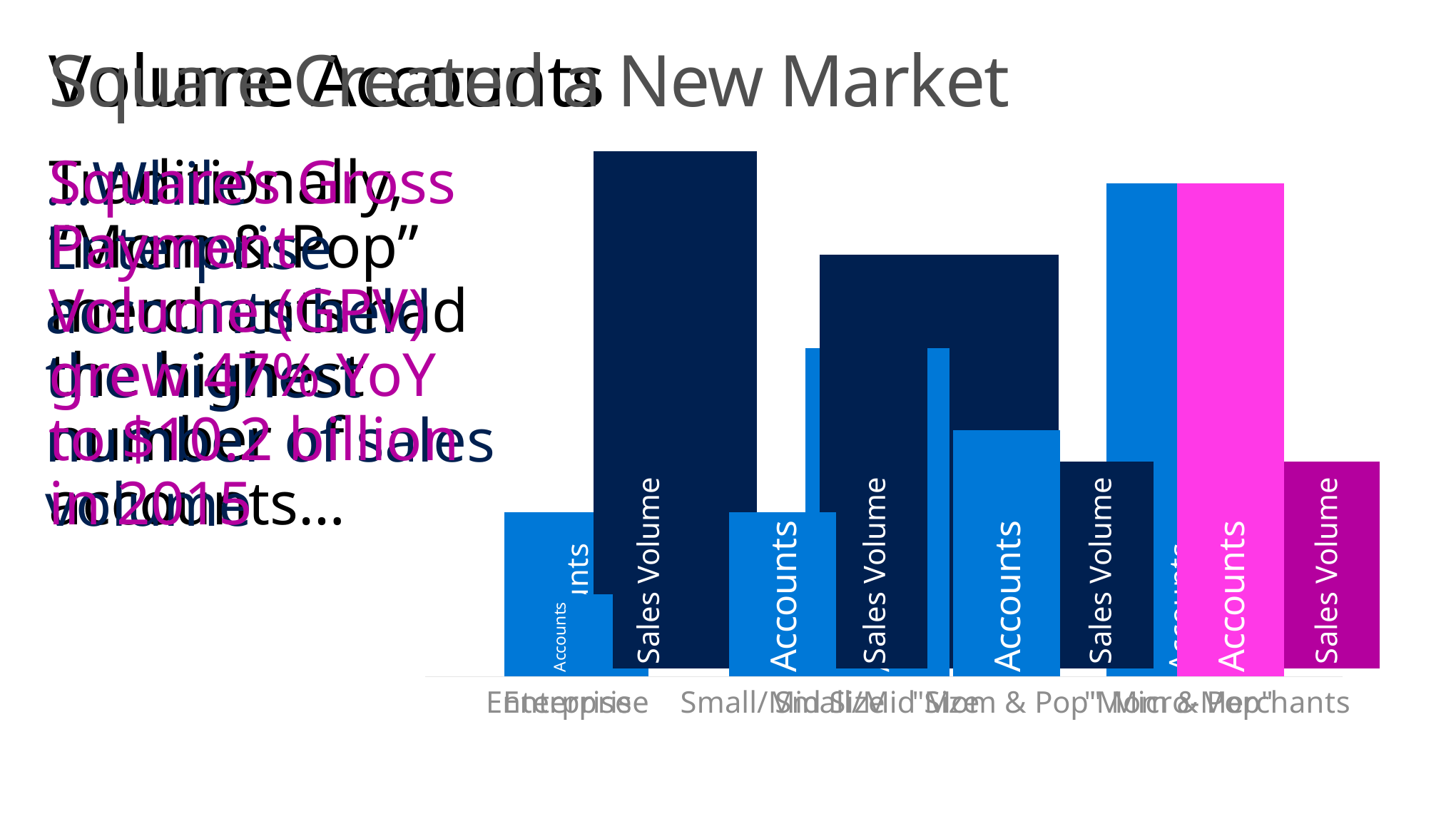
Which category's bars are drawn in pink and purple rather than blue? Micro Merchants What kind of chart is shown on the slide? bar chart What two measures are labelled on the bars of the chart? Accounts and Sales Volume For the Micro Merchants category, which bar is taller: Accounts or Sales Volume? Accounts Which category has the shortest Sales Volume bar? "Mom & Pop" and Micro-Merchants (tied) For the Enterprise category, which bar is taller: Accounts or Sales Volume? Sales Volume Which category has the tallest Sales Volume bar? Enterprise